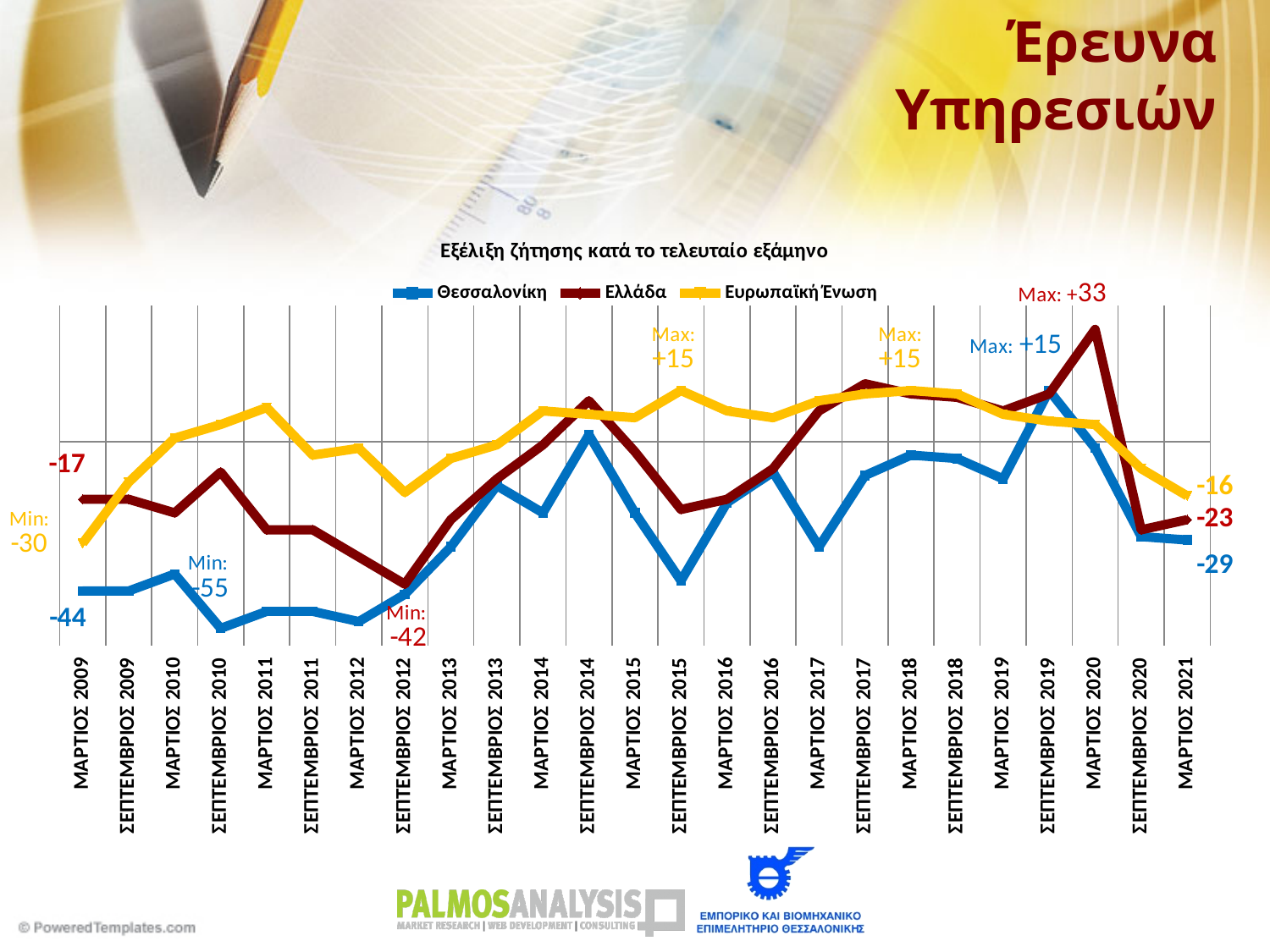
In ΜΑΡΤΙΟΣ 2021, which series has the higher value, Ευρωπαϊκή Ένωση or Ελλάδα? Ευρωπαϊκή Ένωση What is the minimum value reached by the Θεσσαλονίκη series? -55 What is the maximum value reached by the Ελλάδα series? +33 What is the value for Θεσσαλονίκη in ΜΑΡΤΙΟΣ 2021? -29 What kind of chart is shown on the slide? Line chart How many series does the legend list? 3 What is the title of the chart? Εξέλιξη ζήτησης κατά το τελευταίο εξάμηνο In ΜΑΡΤΙΟΣ 2021, what is the difference between the Ελλάδα value and the Θεσσαλονίκη value? 6 What is the value for Ευρωπαϊκή Ένωση in ΜΑΡΤΙΟΣ 2021? -16 What is the value for Ελλάδα in ΜΑΡΤΙΟΣ 2009? -17 How many time points are shown on the x axis? 25 What is the value for Ελλάδα in ΜΑΡΤΙΟΣ 2021? -23